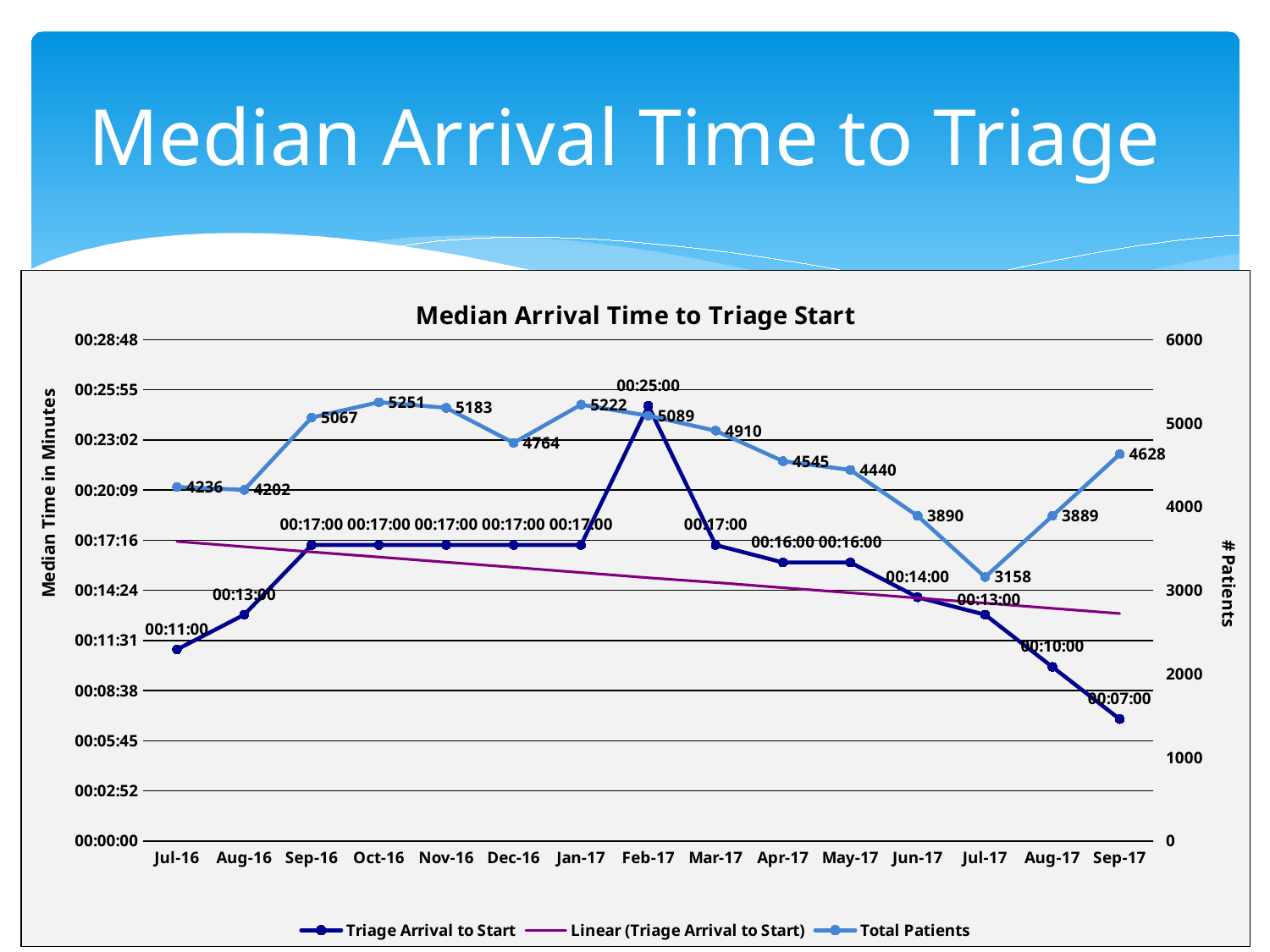
What is the difference between the Total Patients values for Oct-16 and Jul-17? 2093 Which month has the lowest Triage Arrival to Start value? Sep-17 Which month has a larger Total Patients value, Dec-16 or Jan-17? Jan-17 Which month has the highest Total Patients value? Oct-16 What is the Triage Arrival to Start value for Feb-17? 00:25:00 What kind of chart is shown on the slide? Line chart How many months are shown on the x axis? 15 How many entries does the legend list? 3 What is the Total Patients value for Sep-17? 4628 Which month has the lowest Total Patients value? Jul-17 Does the Triage Arrival to Start series rise or fall from Mar-17 to Sep-17? Fall What is the Total Patients value for Oct-16? 5251